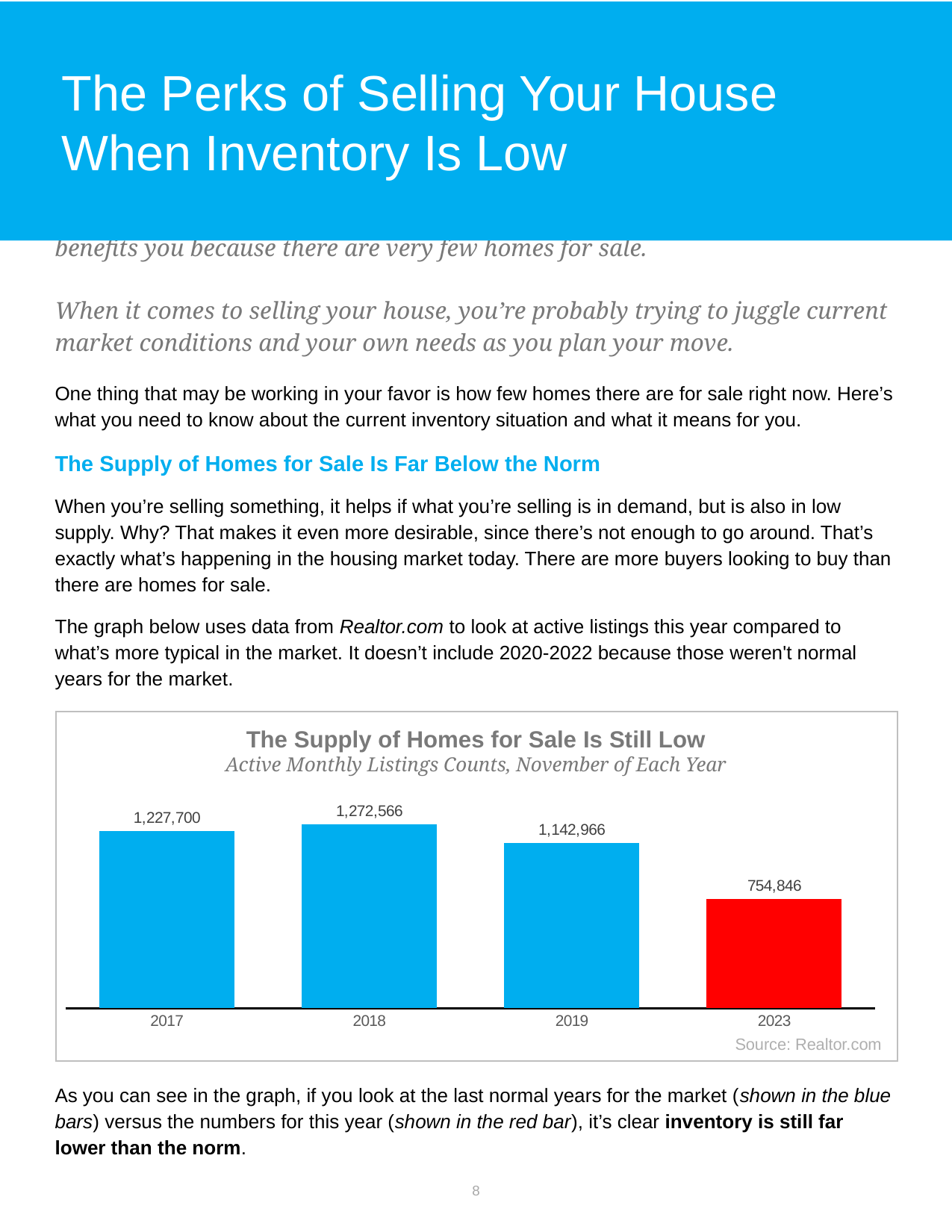
Which year has a larger listings count, 2017 or 2019? 2017 What is the difference between the 2017 and 2019 listings counts? 84,734 What colour is the bar for 2023? Red What is the active monthly listings count for 2019? 1,142,966 What kind of chart is shown on the slide? Bar chart What is the difference between the 2018 and 2023 listings counts? 517,720 What is the active monthly listings count for 2017? 1,227,700 What is the active monthly listings count for 2023? 754,846 What is the title of the chart? The Supply of Homes for Sale Is Still Low How many years are shown in the chart? 4 Which year has the lowest active listings count? 2023 Which year has the highest active listings count? 2018